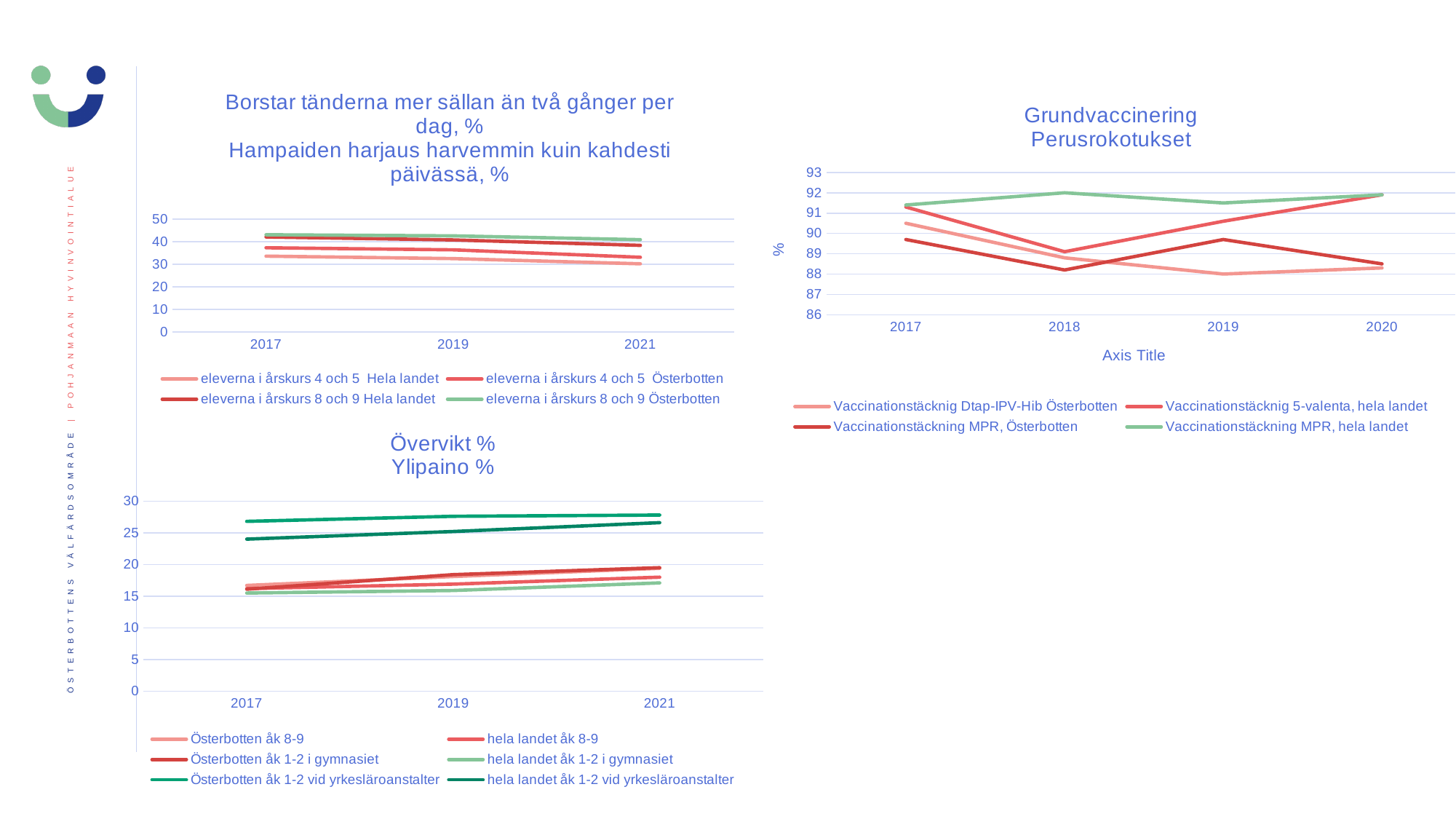
In the 'Övervikt % Ylipaino %' chart, is the 2017 value for 'Österbotten åk 1-2 vid yrkesläroanstalter' greater or less than 25? greater In the 'Grundvaccinering Perusrokotukset' chart, is the 2018 value for 'Vaccinationstäckning MPR, hela landet' greater or less than 91? greater In the 'Borstar tänderna mer sällan än två gånger per dag, %' chart, is the 2021 value for 'eleverna i årskurs 4 och 5 Hela landet' greater or less than 40? less In the 'Grundvaccinering Perusrokotukset' chart, does the 'Vaccinationstäcknig 5-valenta, hela landet' line rise or fall from 2018 to 2020? rise What kind of chart is the 'Grundvaccinering Perusrokotukset' chart? line chart How many years are shown on the x axis of the 'Grundvaccinering Perusrokotukset' chart? 4 How many series does the legend of the 'Övervikt % Ylipaino %' chart list? 6 In the 'Övervikt % Ylipaino %' chart, which is larger in 2021: 'Österbotten åk 1-2 vid yrkesläroanstalter' or 'hela landet åk 1-2 i gymnasiet'? Österbotten åk 1-2 vid yrkesläroanstalter How many series does the legend of the 'Borstar tänderna mer sällan än två gånger per dag, %' chart list? 4 How many years are shown on the x axis of the 'Övervikt % Ylipaino %' chart? 3 What is the x-axis title shown on the 'Grundvaccinering Perusrokotukset' chart? Axis Title